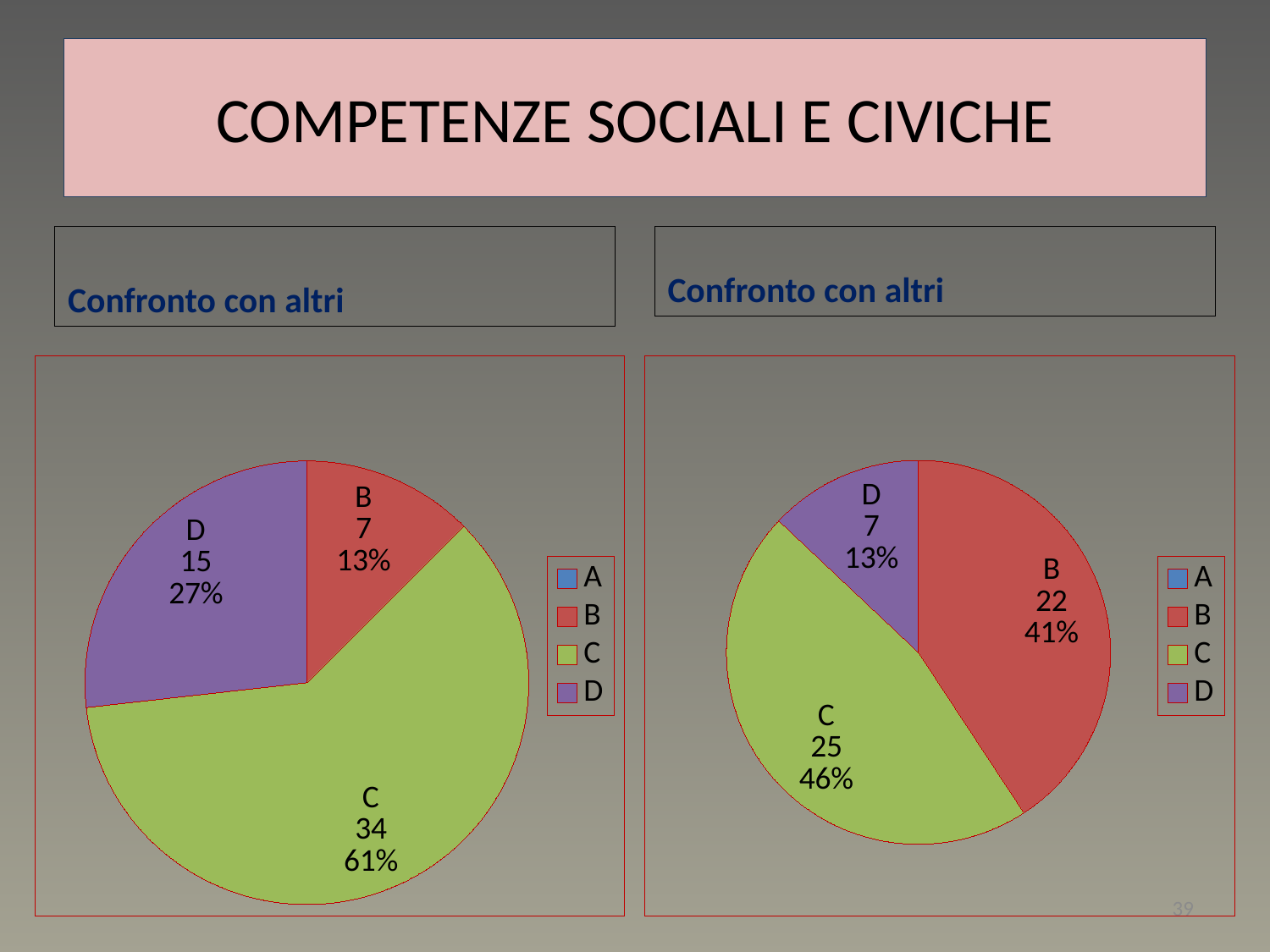
What type of chart is shown on the right side of the slide? Pie chart In the right pie chart, what share of the pie does category C represent? 46% In the right pie chart, which is larger, the value for B or the value for D? B In the left pie chart, what is the value for category C? 34 In the left pie chart, what share of the pie does category D represent? 27% In the left pie chart, which category has the largest slice? C In the left pie chart, which labelled category has the smallest slice? B In the right pie chart, what is the value for category B? 22 How many entries does the legend of the left chart list? 4 In the right pie chart, which labelled category has the smallest slice? D In the right pie chart, what is the difference between the values for C and B? 3 In the left pie chart, what is the difference between the values for C and D? 19